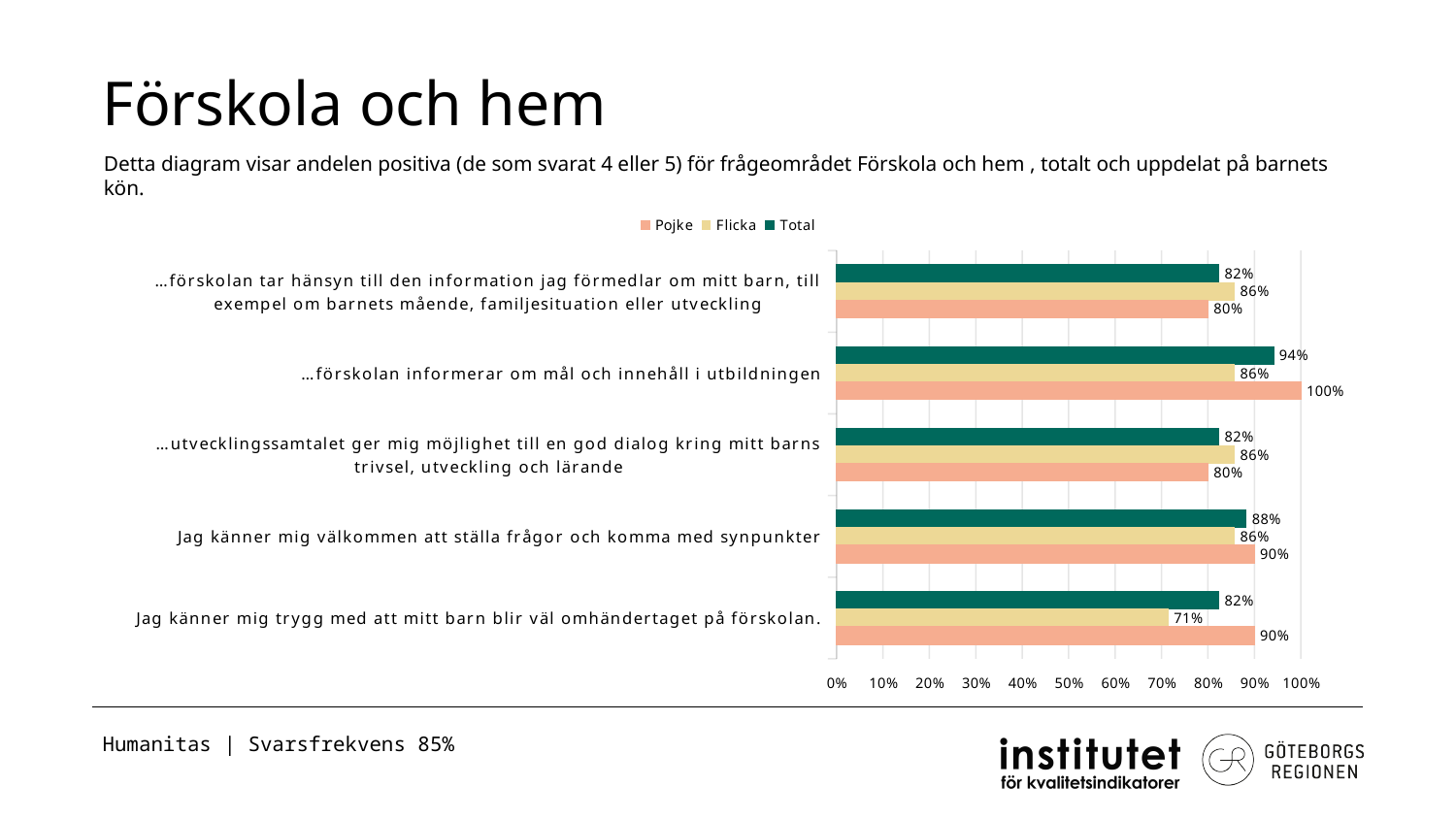
Which series is shown in green in the legend? Total What is the Flicka value for "Jag känner mig trygg med att mitt barn blir väl omhändertaget på förskolan."? 71% What is the difference between the Pojke and Flicka values for "Jag känner mig trygg med att mitt barn blir väl omhändertaget på förskolan."? 19% How many series does the legend list? 3 Is the Pojke value for "…utvecklingssamtalet ger mig möjlighet till en god dialog kring mitt barns trivsel, utveckling och lärande" greater or less than 90%? less How many categories are shown on the chart? 5 What is the Total value for "Jag känner mig välkommen att ställa frågor och komma med synpunkter"? 88% What kind of chart is shown on the slide? bar chart What is the Pojke value for "…förskolan informerar om mål och innehåll i utbildningen"? 100% Which category has the lowest Flicka value? Jag känner mig trygg med att mitt barn blir väl omhändertaget på förskolan. For "…förskolan informerar om mål och innehåll i utbildningen", which is larger, the Pojke value or the Flicka value? Pojke Which category has the highest Total value? …förskolan informerar om mål och innehåll i utbildningen